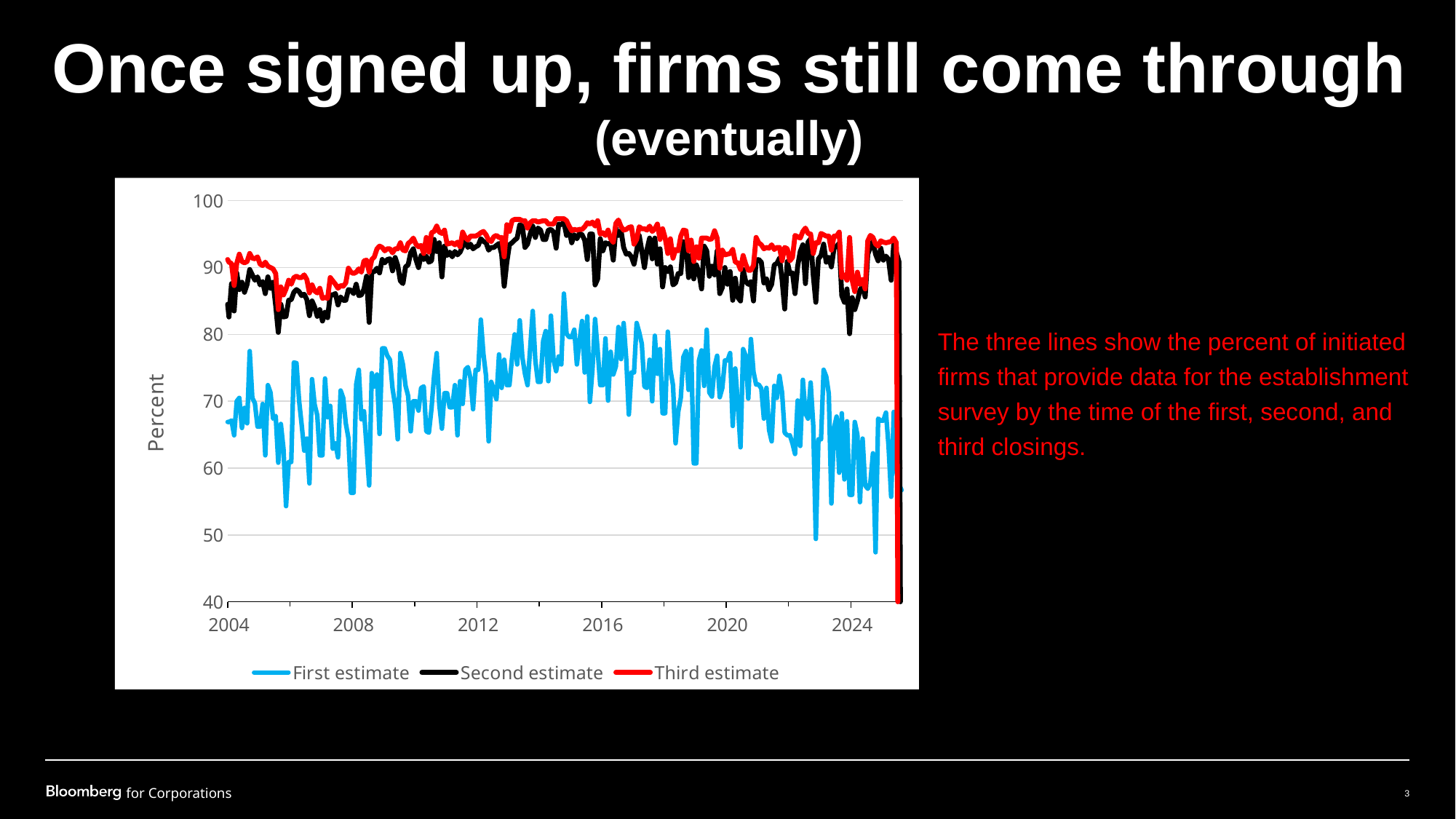
What kind of chart is shown on the slide? Line chart How many series does the chart's legend list? 3 What is the lowest value shown on the chart's vertical axis? 40 What is the label on the chart's vertical axis? Percent Is the value of the First estimate line at the start of 2004 greater or less than 80? less What are the three series named in the chart's legend? First estimate, Second estimate, Third estimate Around 2016, which is larger: the Third estimate or the First estimate? Third estimate Does the First estimate line generally rise or fall between 2016 and 2024? Fall Which series is plotted lowest on the chart across the whole period? First estimate Which series is plotted highest on the chart across the whole period? Third estimate Is the value of the First estimate line at the start of 2004 greater or less than 60? greater